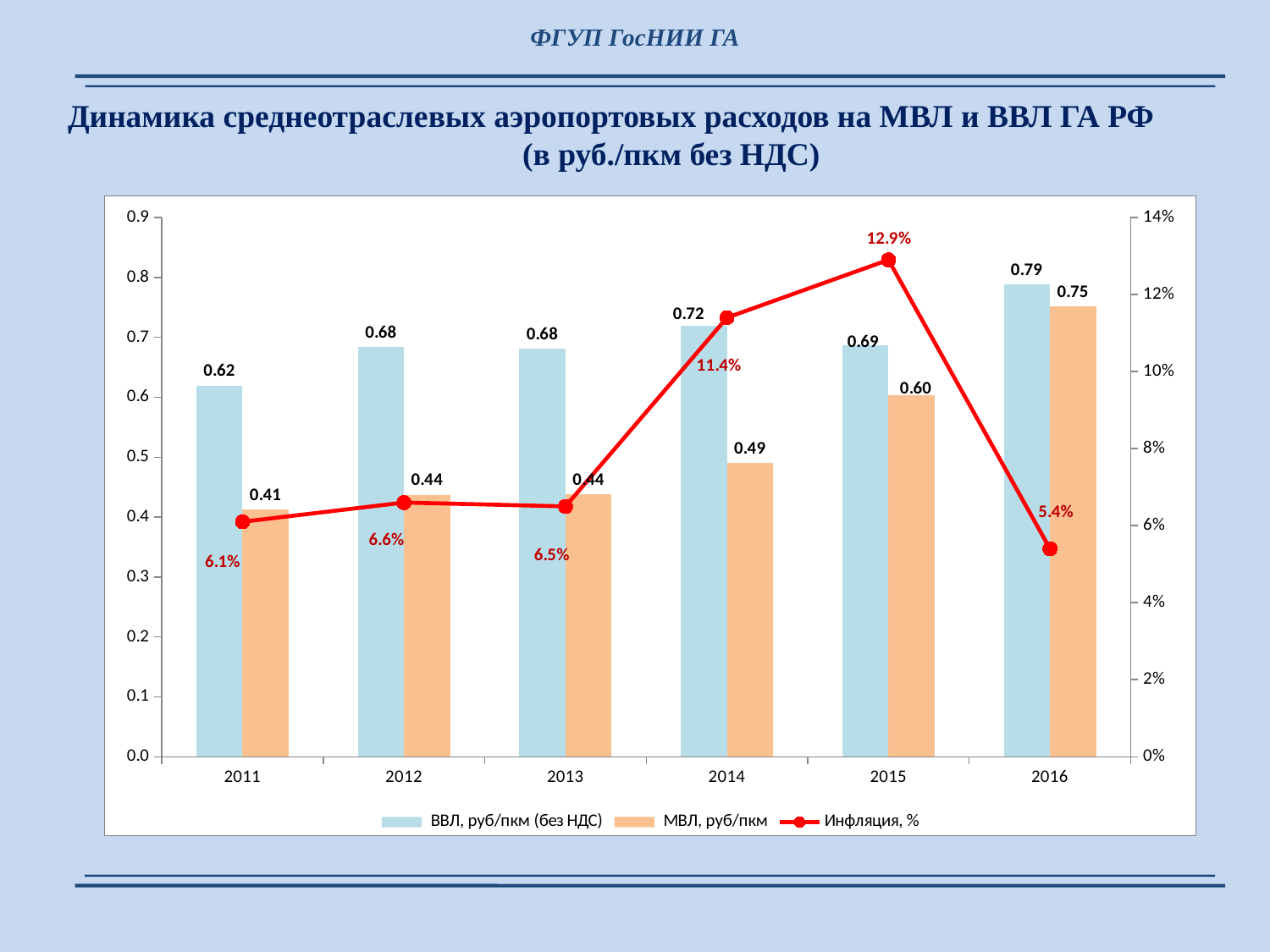
What is the difference between ВВЛ, руб/пкм (без НДС) and МВЛ, руб/пкм in 2011? 0.21 How many years are shown on the x axis? 6 What is the Инфляция, % value for 2012? 6.6% What kind of chart is this? Combined bar and line chart What is the value of МВЛ, руб/пкм in 2015? 0.60 Which is larger in 2016: ВВЛ, руб/пкм (без НДС) or МВЛ, руб/пкм? ВВЛ, руб/пкм (без НДС) In which year is МВЛ, руб/пкм lowest? 2011 Does МВЛ, руб/пкм rise or fall from 2013 to 2016? Rise What is the Инфляция, % value for 2016? 5.4% How many series does the legend list? 3 What is the value of ВВЛ, руб/пкм (без НДС) in 2014? 0.72 In which year is Инфляция, % highest? 2015